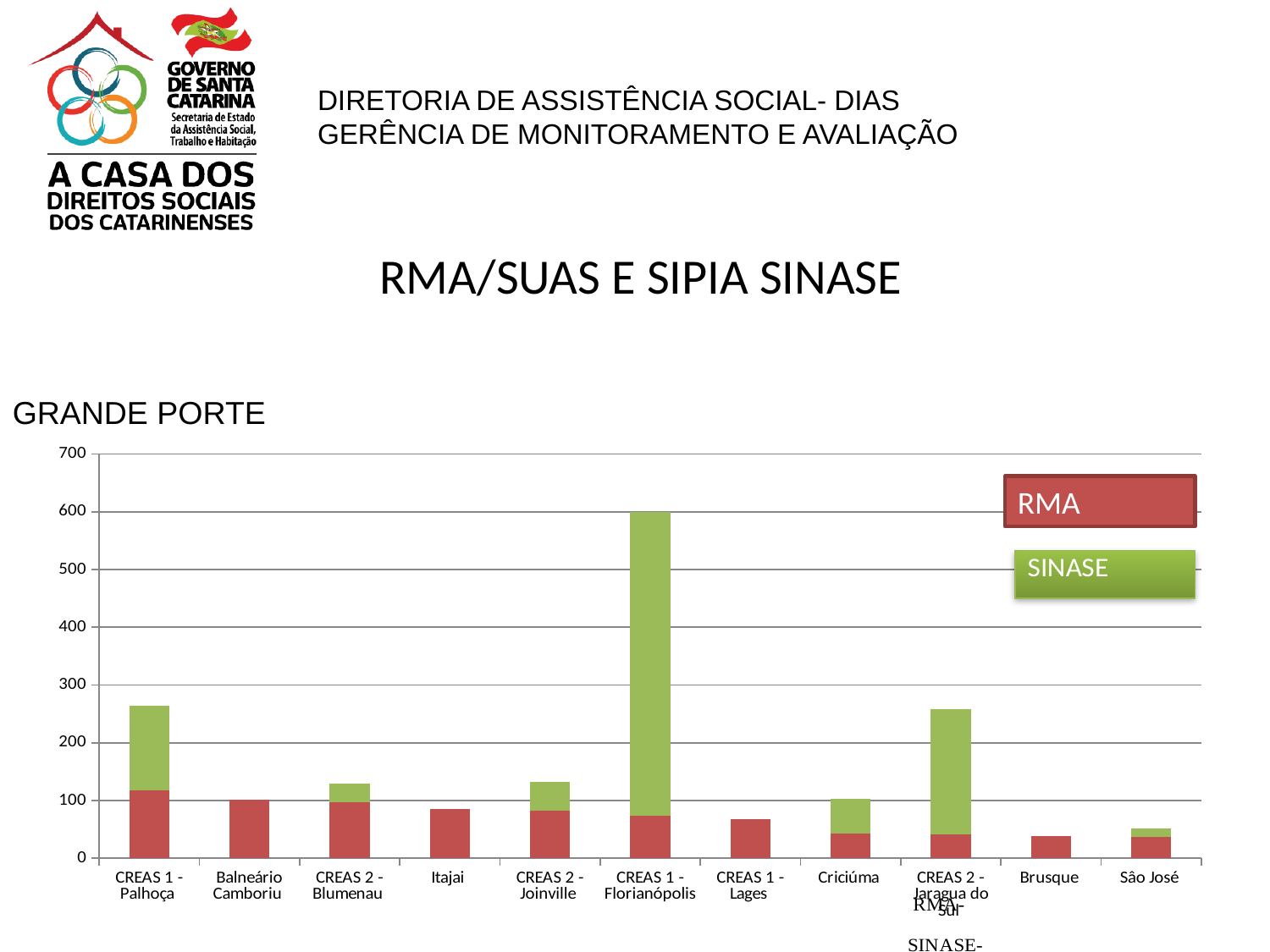
Is the total stacked value for CREAS 2 - Jaragua do Sul greater or less than 200? greater Which category has the tallest stacked bar in the chart? CREAS 1 - Florianópolis Is the total stacked value for CREAS 1 - Florianópolis greater or less than 500? greater Is the total stacked value for CREAS 1 - Palhoça greater or less than 200? greater How many series does the chart legend list? 2 How many categories are shown on the x axis of the chart? 11 What is the title shown above the chart? GRANDE PORTE Which has the larger total stacked bar, CREAS 1 - Florianópolis or CREAS 2 - Jaragua do Sul? CREAS 1 - Florianópolis What kind of chart is shown on the slide? bar chart Which colour represents the SINASE series in the chart? green